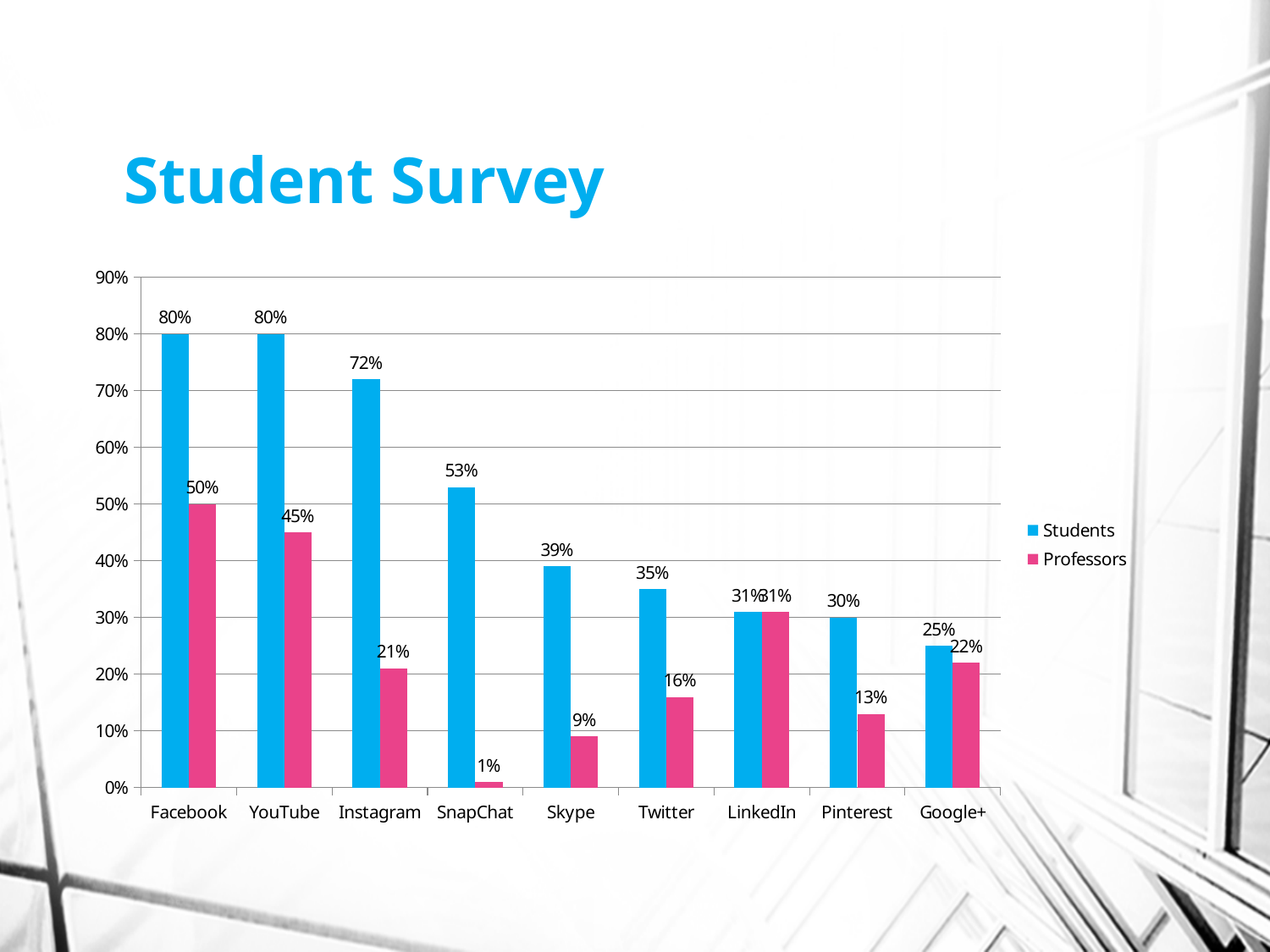
How many platforms are shown on the x axis? 9 Do the Students values rise or fall from Facebook to Google+ along the x axis? Fall What is the difference between the Students and Professors values for Instagram? 51% What is the title of the slide? Student Survey What kind of chart is shown on the slide? Bar chart Which is larger for Google+, the Students value or the Professors value? Students What percentage of students use Instagram? 72% What percentage of professors use SnapChat? 1% Which platform has the highest value for Professors? Facebook Which platform has the lowest value for Professors? SnapChat What is the value for Professors on Twitter? 16% How many series does the legend list? 2